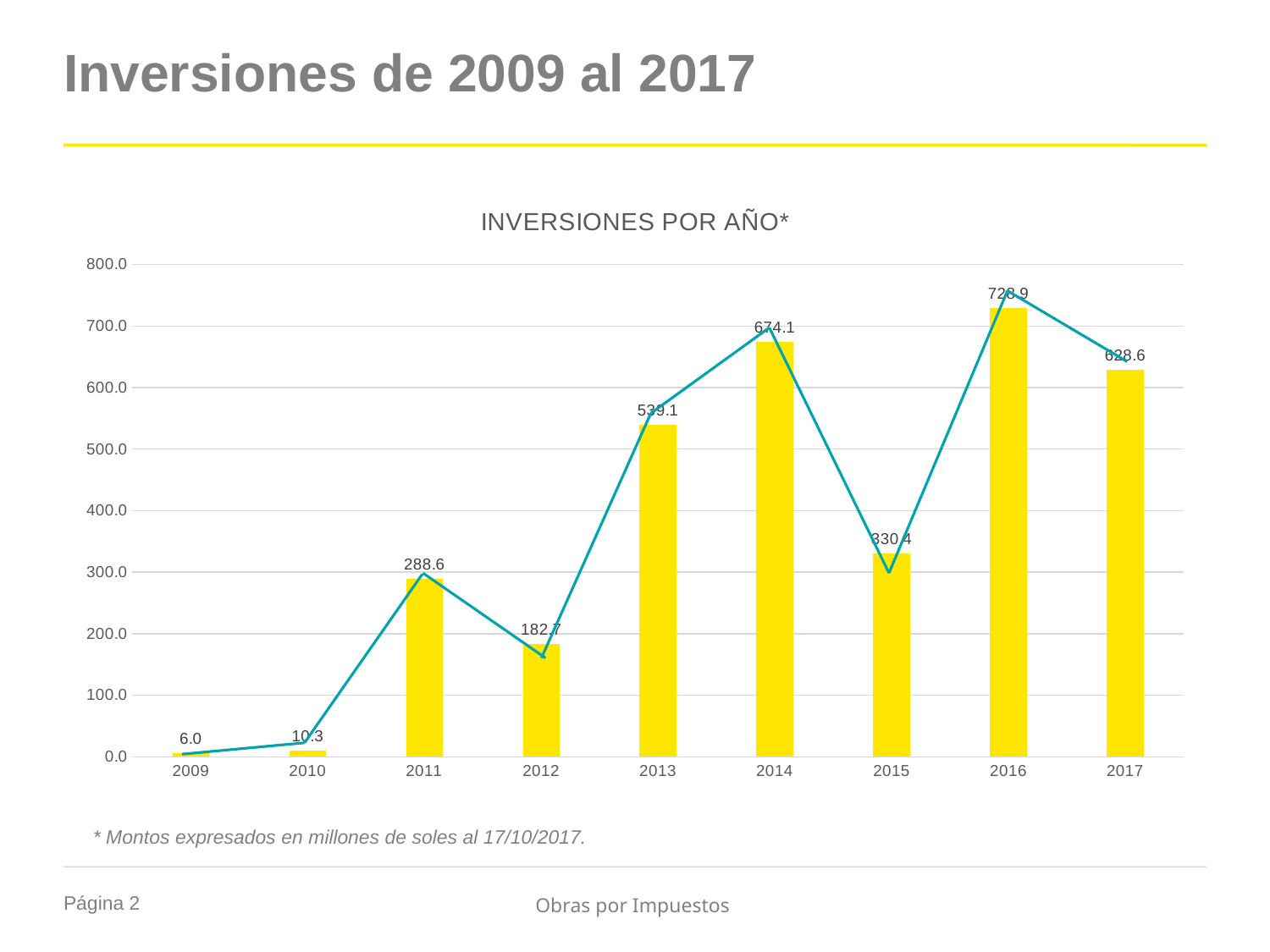
What is the value for 2012? 182.7 What is the title of the chart? INVERSIONES POR AÑO* Is the value for 2015 greater or less than 400.0? less Which year has the highest value? 2016 What is the value for 2009? 6.0 What is the value for 2014? 674.1 How many years are shown on the x axis? 9 What is the difference between the values for 2010 and 2009? 4.3 Which year has the lowest value? 2009 What is the value for 2011? 288.6 Which is larger, the value for 2014 or the value for 2017? 2014 What is the difference between the values for 2011 and 2012? 105.9